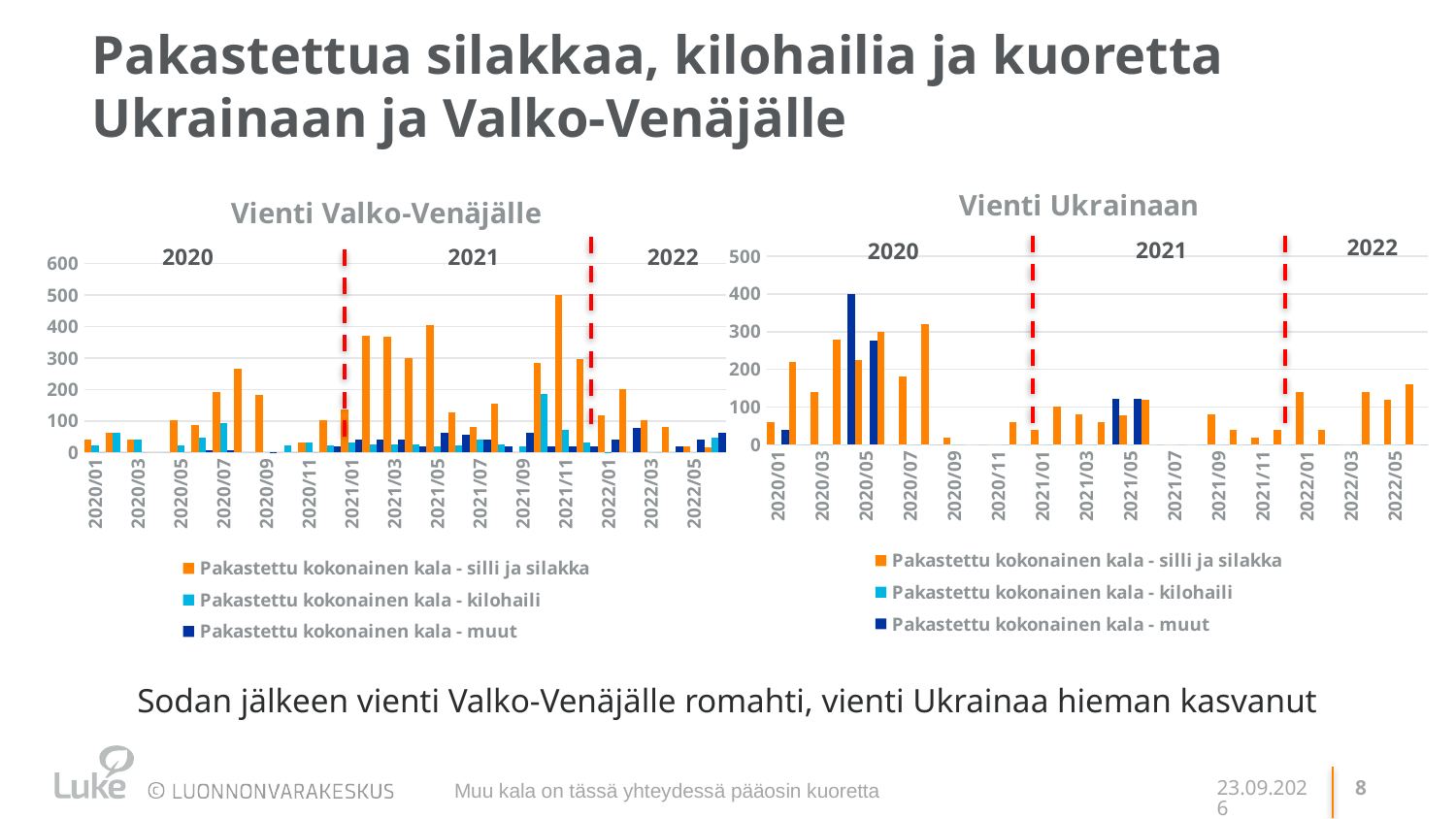
In the "Vienti Valko-Venäjälle" chart, which is larger for "silli ja silakka": 2021/11 or 2021/05? 2021/11 How many series does the legend of the "Vienti Ukrainaan" chart list? 3 In the "Vienti Valko-Venäjälle" chart, which month has the highest bar for "Pakastettu kokonainen kala - silli ja silakka"? 2021/11 In the "Vienti Ukrainaan" chart, which month has the highest bar for "Pakastettu kokonainen kala - muut"? 2020/04 In the "Vienti Ukrainaan" chart, is the value for "muut" in 2020/04 greater or less than 300? greater In the "Vienti Ukrainaan" chart, is the value for "silli ja silakka" in 2022/05 greater or less than 100? greater What is the title of the chart on the right side of the slide? Vienti Ukrainaan In the "Vienti Ukrainaan" chart, is the value for "silli ja silakka" in 2020/07 greater or less than 200? less What is the highest value shown on the y axis of the "Vienti Valko-Venäjälle" chart? 600 What kind of chart is "Vienti Valko-Venäjälle"? bar chart